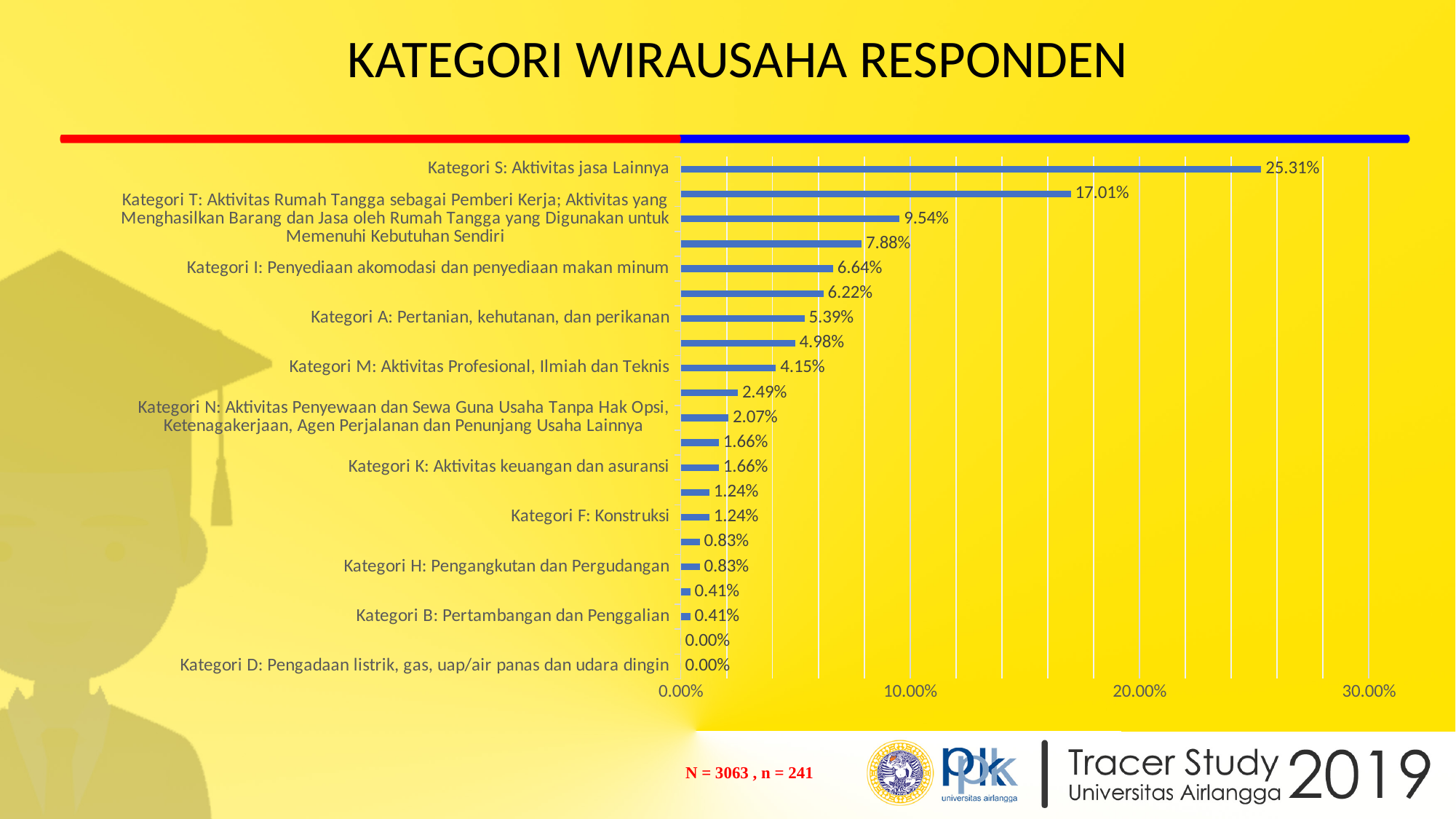
What is the difference between the values for Kategori S and Kategori T? 15.77% What is the value for Kategori K: Aktivitas keuangan dan asuransi? 1.66% What is the value for Kategori I: Penyediaan akomodasi dan penyediaan makan minum? 6.64% How many bars are plotted in the chart? 21 Which has a larger value, Kategori I or Kategori A? Kategori I What kind of chart is shown on the slide? Bar chart What is the value for Kategori A: Pertanian, kehutanan, dan perikanan? 5.39% What is the value for Kategori T: Aktivitas Rumah Tangga sebagai Pemberi Kerja? 9.54% What is the value for Kategori S: Aktivitas jasa Lainnya? 25.31% What is the value for Kategori H: Pengangkutan dan Pergudangan? 0.83% What is the value for Kategori M: Aktivitas Profesional, Ilmiah dan Teknis? 4.15% Which category has the highest value? Kategori S: Aktivitas jasa Lainnya